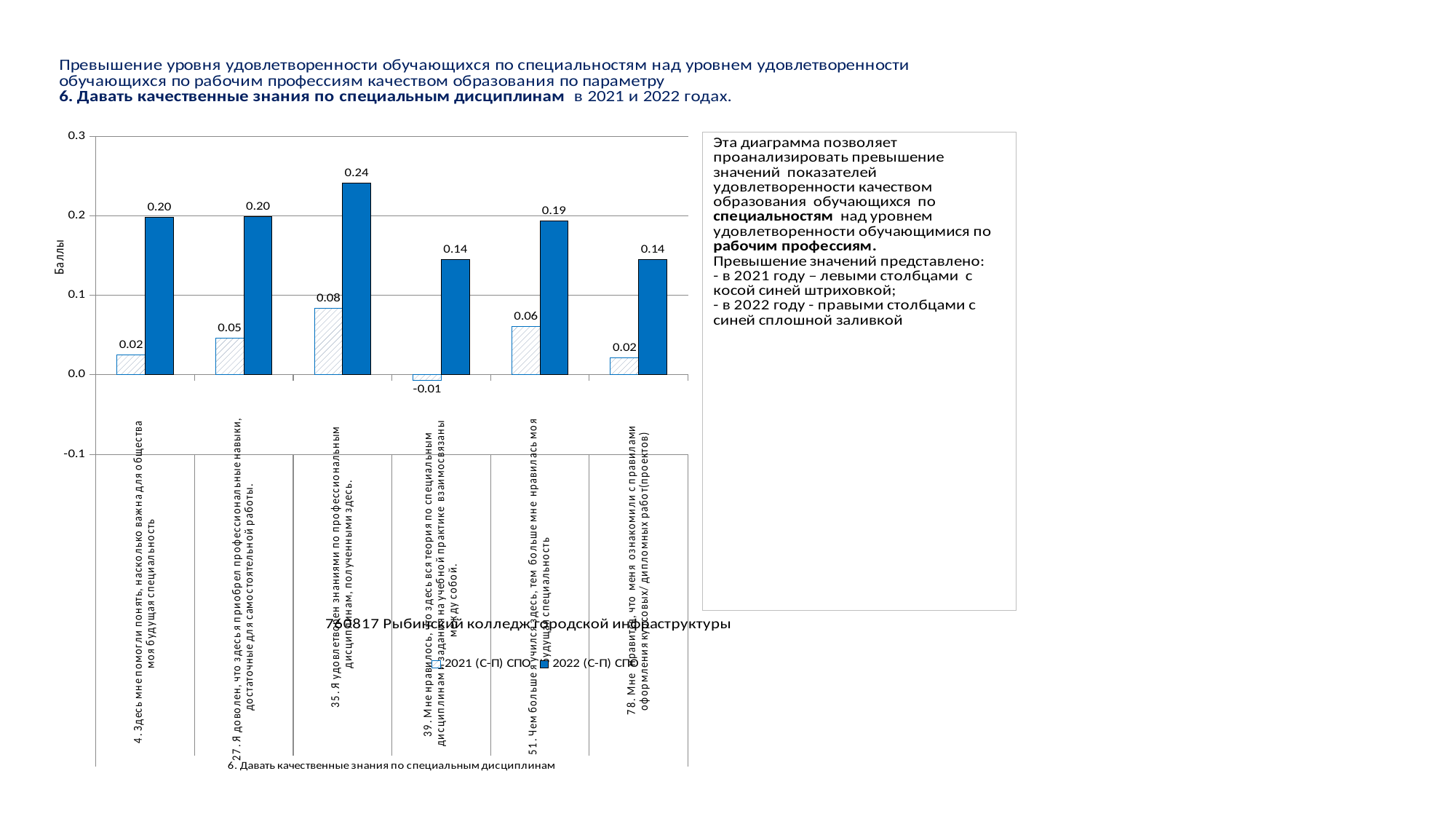
How many series does the chart legend list? 2 Which category has the highest 2022 (С-П) СПО value? 35. Я удовлетворен знаниями по профессиональным дисциплинам, полученными здесь. What is the 2021 (С-П) СПО value for question 39 (Мне нравилось, что здесь вся теория по специальным дисциплинам и задания на учебной практике взаимосвязаны между собой)? -0.01 Which category has the lowest 2021 (С-П) СПО value? 39. Мне нравилось, что здесь вся теория по специальным дисциплинам и задания на учебной практике взаимосвязаны между собой. Is the 2022 (С-П) СПО value for question 51 greater or less than 0.1? greater What is the 2021 (С-П) СПО value for question 51 (Чем больше я учился здесь, тем больше мне нравилась моя будущая специальность)? 0.06 What type of chart is shown on the slide? Bar chart What is the 2022 (С-П) СПО value for question 35 (Я удовлетворен знаниями по профессиональным дисциплинам, полученными здесь)? 0.24 What is the difference between the 2022 and 2021 (С-П) СПО values for question 4 (Здесь мне помогли понять, насколько важна для общества моя будущая специальность)? 0.18 Which is larger for question 78: the 2021 (С-П) СПО value or the 2022 (С-П) СПО value? 2022 (С-П) СПО How many categories (questions) are shown on the x axis of the chart? 6 What is the label of the vertical axis of the chart? Баллы